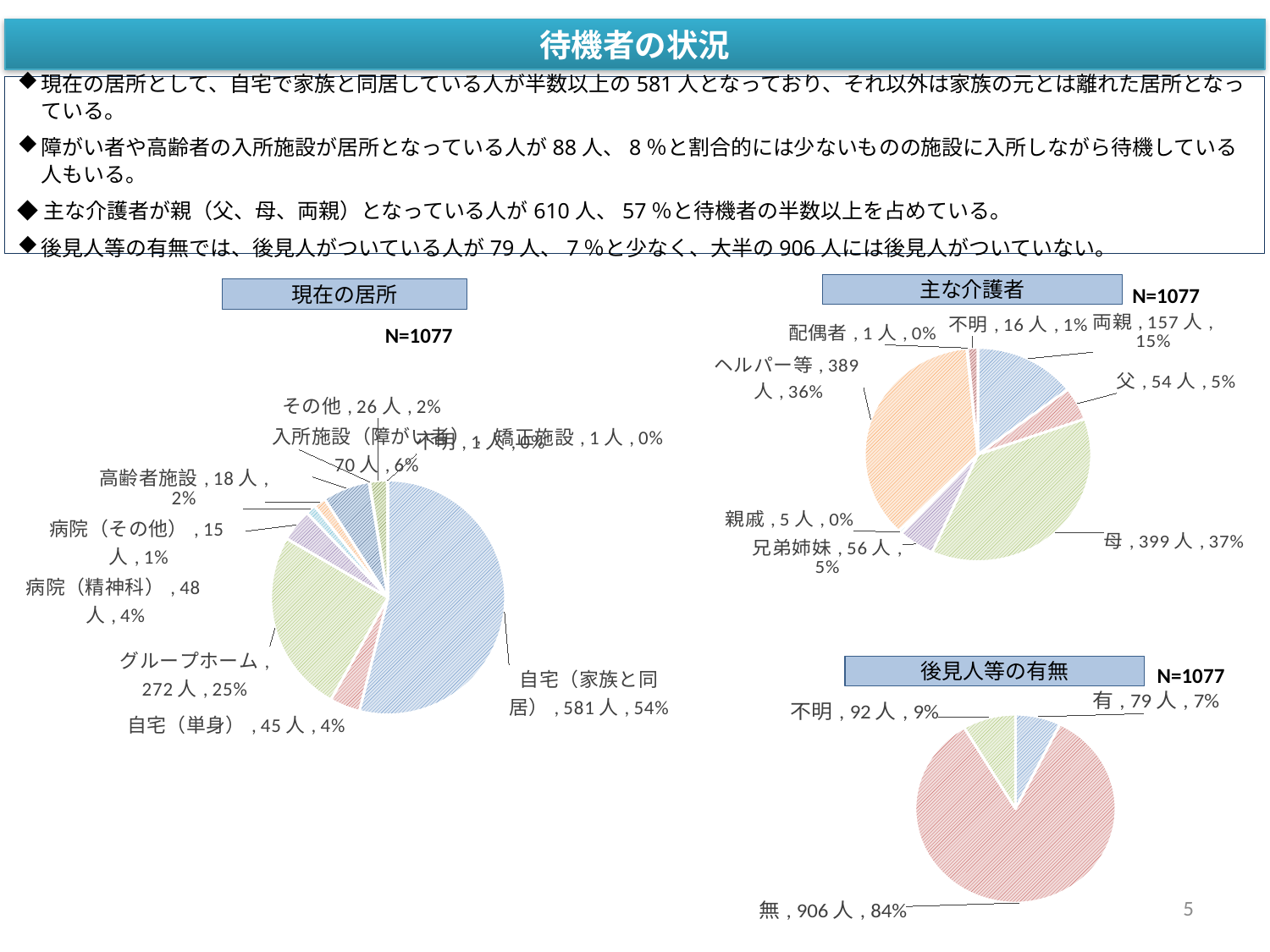
In the 主な介護者 pie chart, what is the difference in people between 兄弟姉妹 and 父? 2 人 In the 現在の居所 pie chart, which category has the largest slice? 自宅（家族と同居） In the 現在の居所 pie chart, what is the difference in people between グループホーム and 入所施設（障がい者）? 202 人 In the 現在の居所 pie chart, how many people are in the 自宅（家族と同居） category? 581 人 In the 現在の居所 pie chart, what percentage share does グループホーム have? 25% In the 主な介護者 pie chart, which is larger, 母 or ヘルパー等? 母 In the 後見人等の有無 pie chart, how many people are in the 無 category? 906 人 How many categories does the 後見人等の有無 pie chart show? 3 In the 主な介護者 pie chart, what percentage share does 両親 have? 15% In the 主な介護者 pie chart, how many people have 母 as their main caregiver? 399 人 In the 後見人等の有無 pie chart, which category has the smallest slice? 有 What type of chart is used for 主な介護者? Pie chart